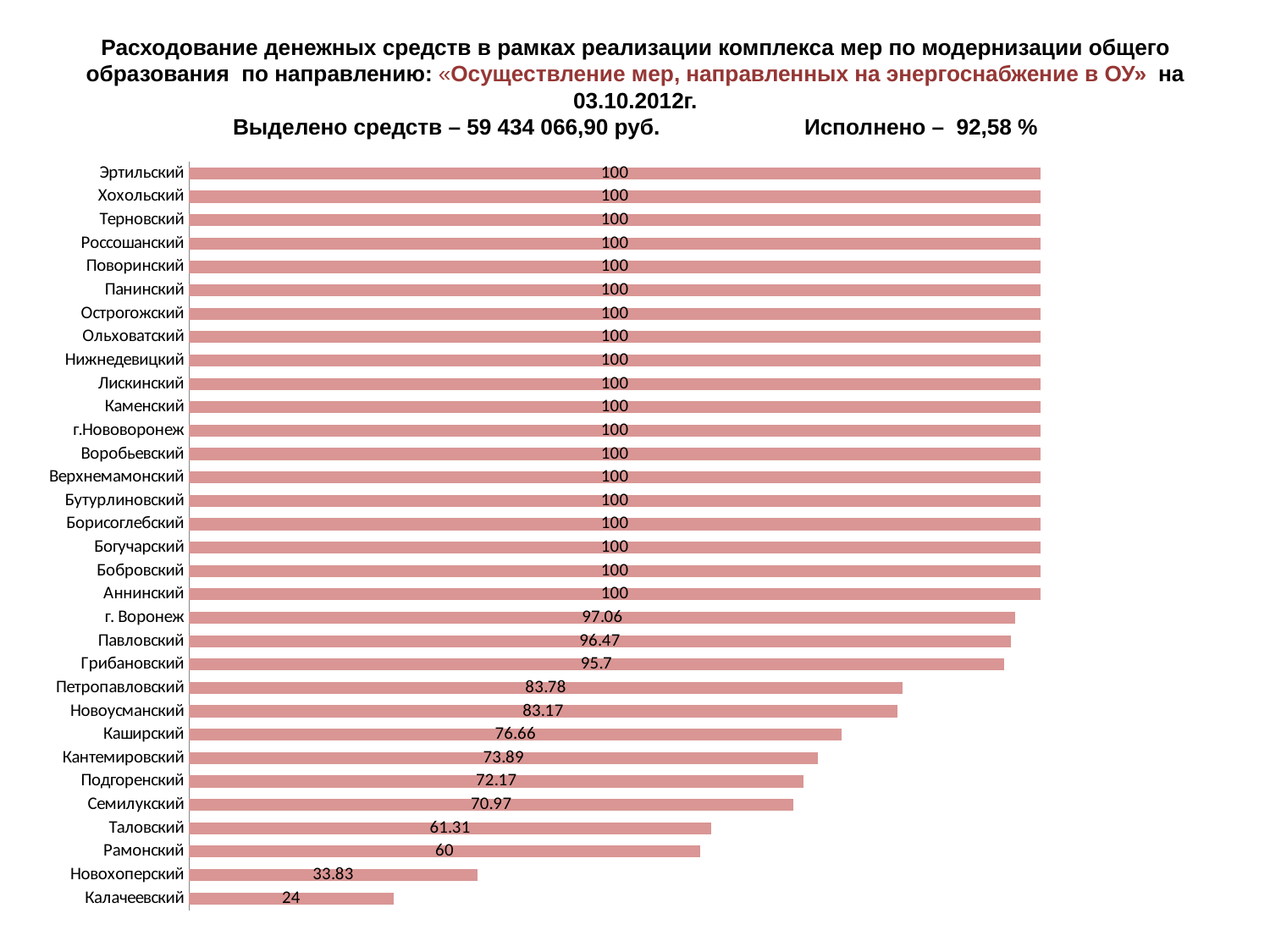
What is the difference between the values for Новохоперский and Калачеевский? 9.83 What is the value for Каширский? 76.66 What is the value for Калачеевский? 24 What kind of chart is shown on the slide? Bar chart Which is larger, the value for Таловский or the value for Кантемировский? Кантемировский Which category has the lowest value? Калачеевский What is the difference between the values for Павловский and Грибановский? 0.77 What is the value for Рамонский? 60 What is the value for Подгоренский? 72.17 How many categories are shown in the chart? 32 What is the value for г. Воронеж? 97.06 Which is larger, the value for Петропавловский or the value for Семилукский? Петропавловский